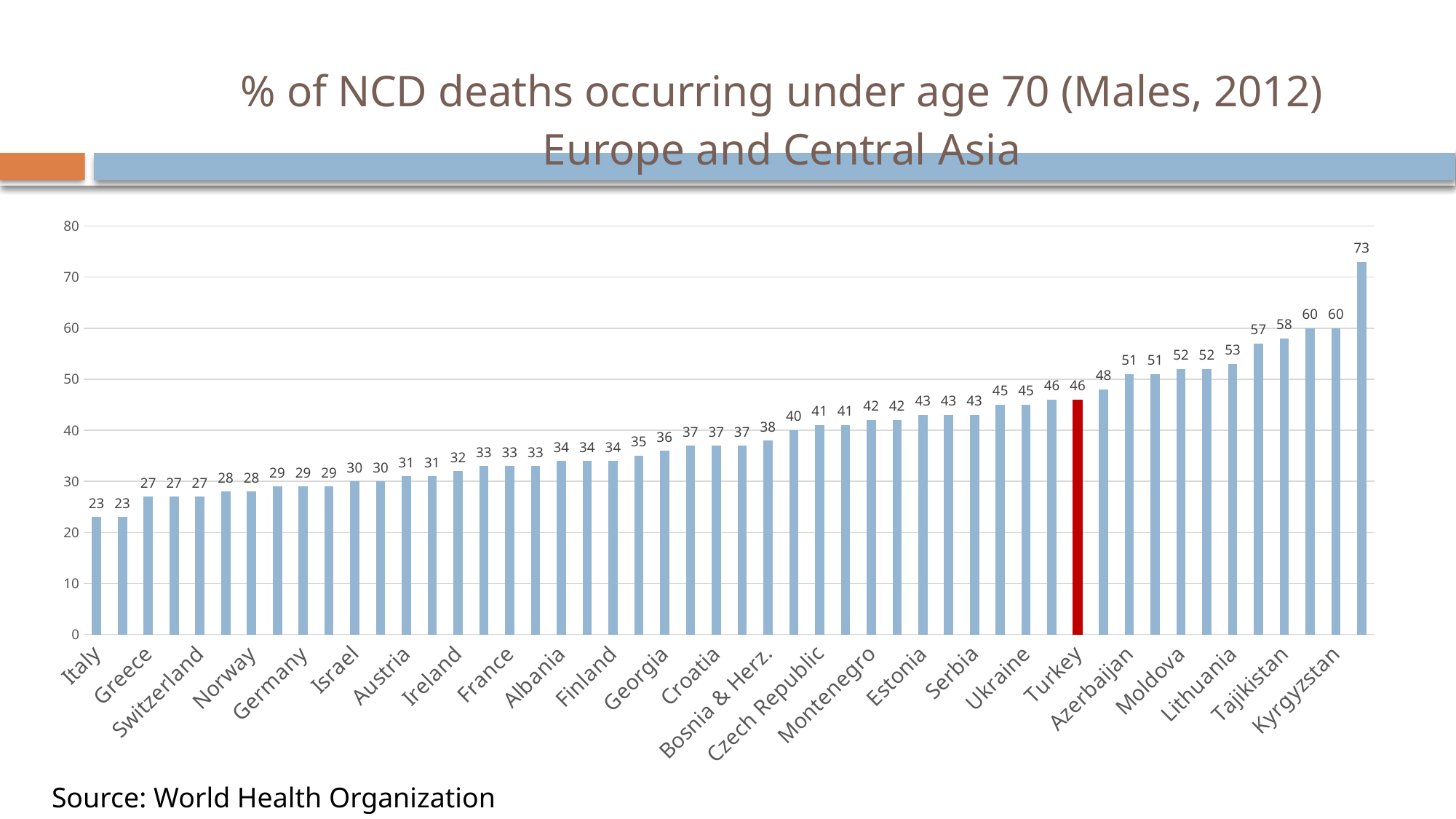
What is the difference between the value for Turkey and the value for Italy? 23 Is the value for Italy greater or less than 30? less Is the value for Turkey greater or less than 40? greater What is the value for Turkey, the red bar? 46 Which country is highlighted with a red bar? Turkey Do the values generally rise or fall from left to right along the x axis? rise What is the highest value shown in the chart? 73 What is the source cited for the chart? World Health Organization What is the lowest value shown in the chart? 23 What is the value for Italy? 23 Which has a larger value, Turkey or Italy? Turkey What type of chart is shown on the slide? bar chart